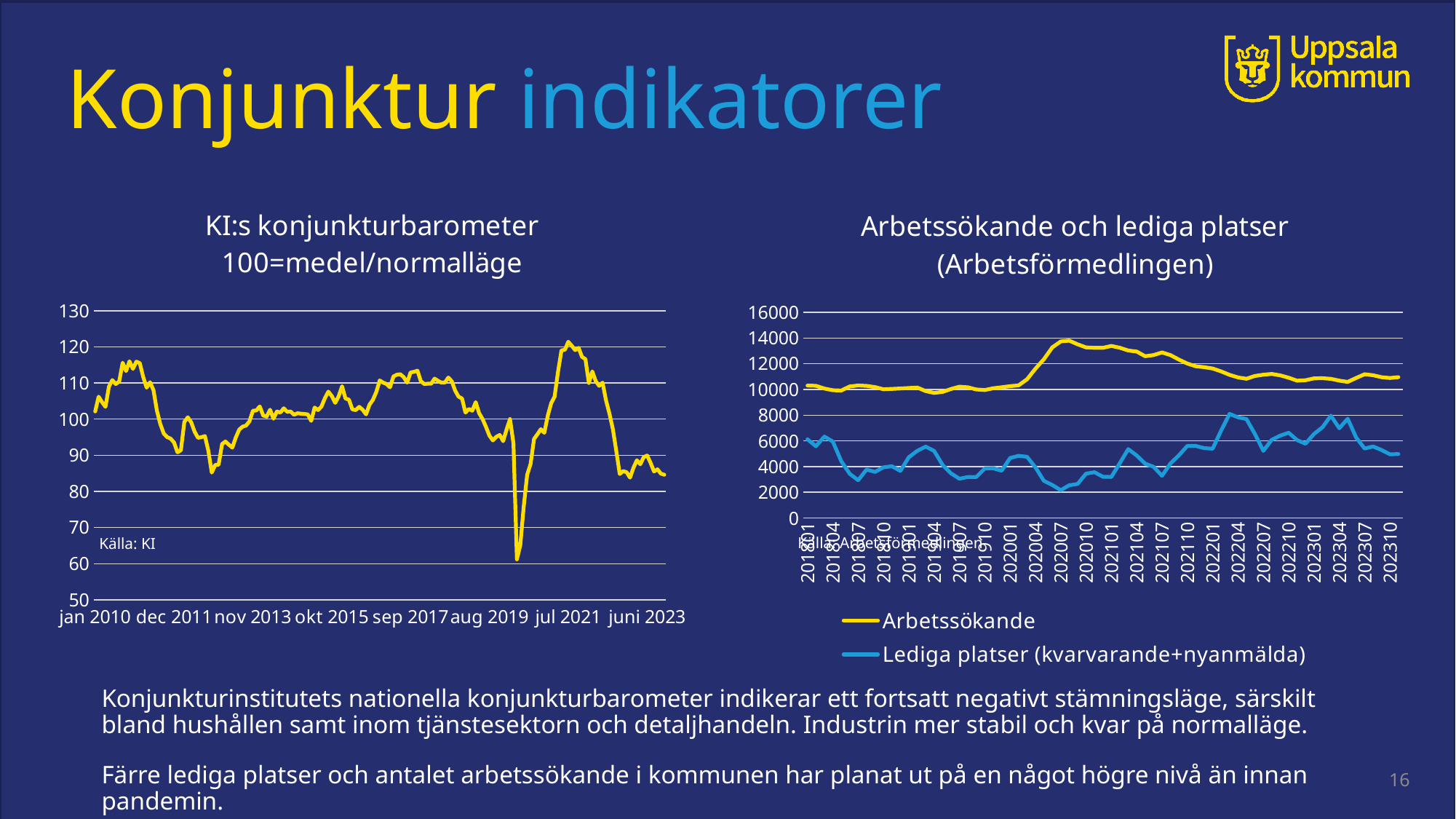
In the 'KI:s konjunkturbarometer' chart, does the line rise or fall between jul 2021 and juni 2023? fall What kind of chart is the 'Arbetssökande och lediga platser' chart on the right? line chart In the 'Arbetssökande och lediga platser' chart, is the Lediga platser value at 202007 greater or less than 4000? less In the 'KI:s konjunkturbarometer' chart, is the peak of the line around 2021 greater or less than 110? greater In the 'Arbetssökande och lediga platser' chart, is the Arbetssökande value at 202007 greater or less than 12000? greater What kind of chart is the 'KI:s konjunkturbarometer' chart on the left? line chart How many series does the legend of the 'Arbetssökande och lediga platser' chart list? 2 In the 'Arbetssökande och lediga platser' chart, which series is higher at 202007: Arbetssökande or Lediga platser? Arbetssökande What source is cited below the 'KI:s konjunkturbarometer' chart? Källa: KI What are the two legend entries of the 'Arbetssökande och lediga platser' chart? Arbetssökande; Lediga platser (kvarvarande+nyanmälda)